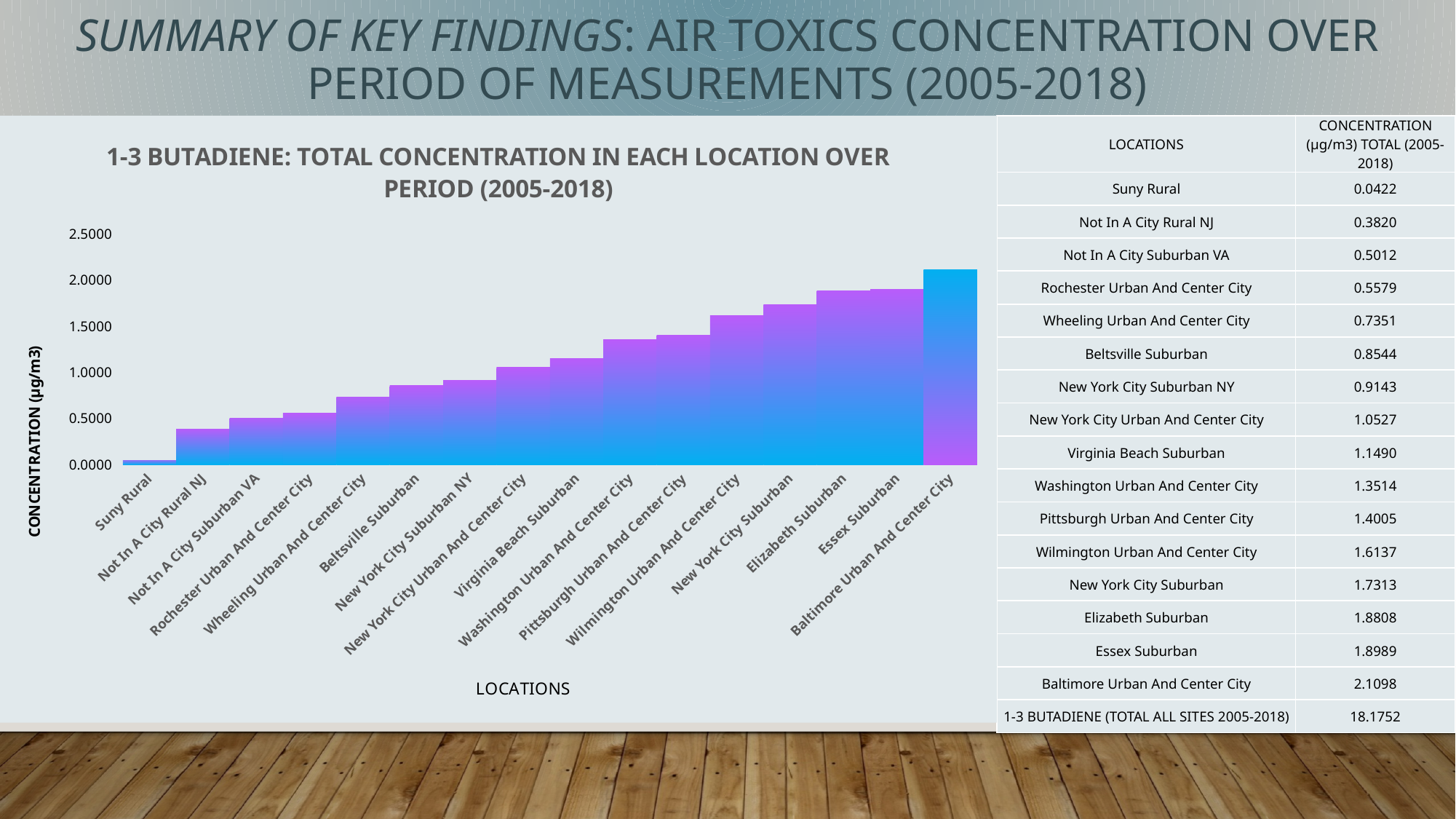
What is the total 1-3 Butadiene concentration across all sites (2005-2018) shown in the table? 18.1752 How many locations are plotted in the 1-3 Butadiene chart? 16 What is the total 1-3 Butadiene concentration for Wheeling Urban And Center City? 0.7351 Which location has the lowest total 1-3 Butadiene concentration? Suny Rural What is the total 1-3 Butadiene concentration for Essex Suburban? 1.8989 What is the difference between the concentrations for Baltimore Urban And Center City and Suny Rural? 2.0676 What kind of chart is shown on the slide? bar chart Is the value for Beltsville Suburban greater or less than 1.0000? less Which location has the highest total 1-3 Butadiene concentration? Baltimore Urban And Center City What is the label of the y axis of the chart? CONCENTRATION (µg/m3) Do the bar values rise or fall from left to right along the x axis? rise Which has a larger total concentration, Wilmington Urban And Center City or Pittsburgh Urban And Center City? Wilmington Urban And Center City